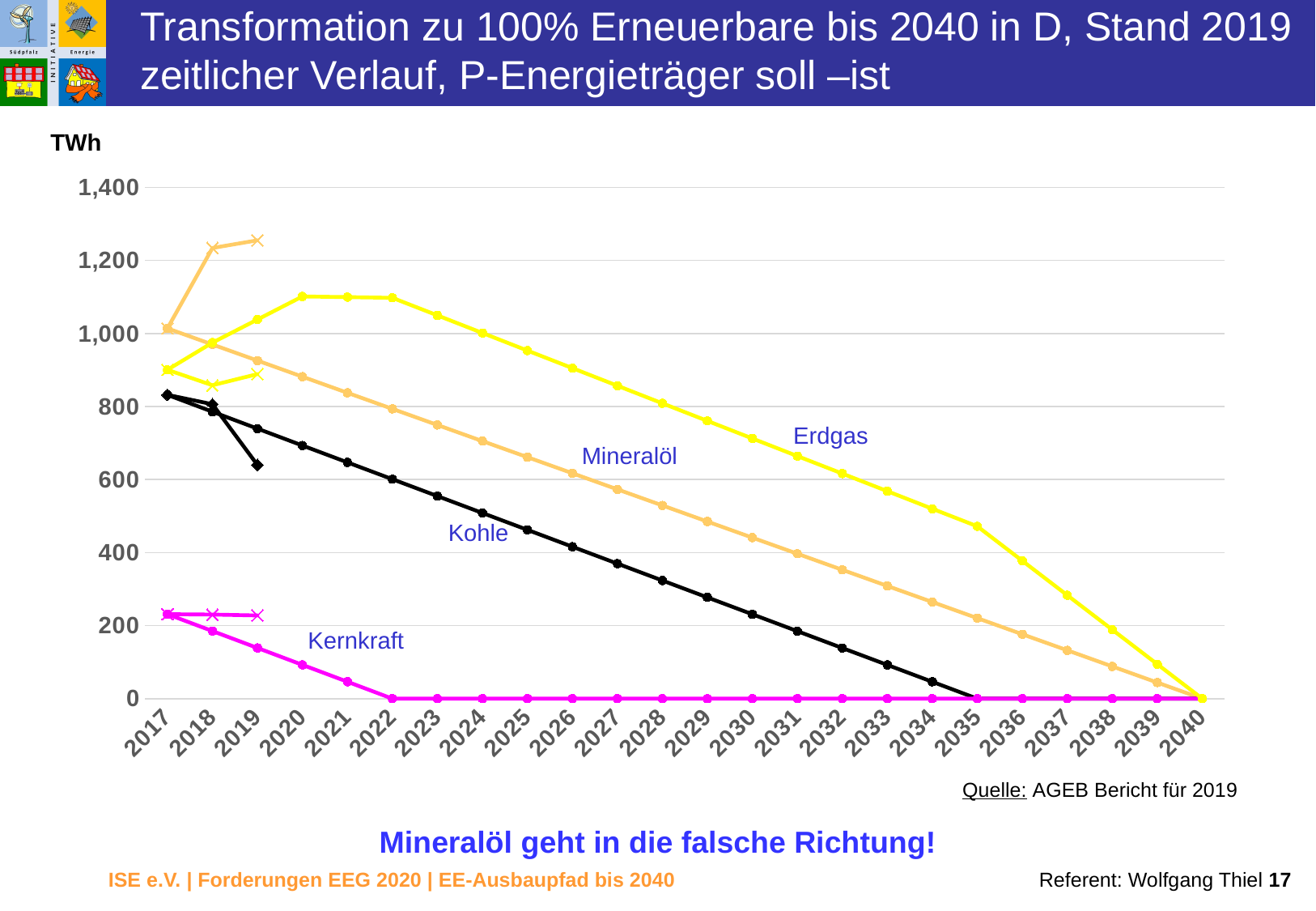
Does the Kohle line rise or fall from 2017 to 2035? fall Which energy source has the highest value in 2030? Erdgas Which line is highest in 2030: Erdgas or Mineralöl? Erdgas How many years are shown along the x axis of the chart? 24 Is the value of the Erdgas line in 2020 greater or less than 1,000? greater What unit is given for the y axis of the chart? TWh What kind of chart is shown on the slide? line chart In which year does the Kernkraft line first reach 0? 2022 Is the value of the Mineralöl line in 2030 greater or less than 400? greater Is the value of the Kohle line in 2017 greater or less than 800? greater What is the value of the Kohle line in 2035? 0 What is the value of the Kernkraft line in 2025? 0